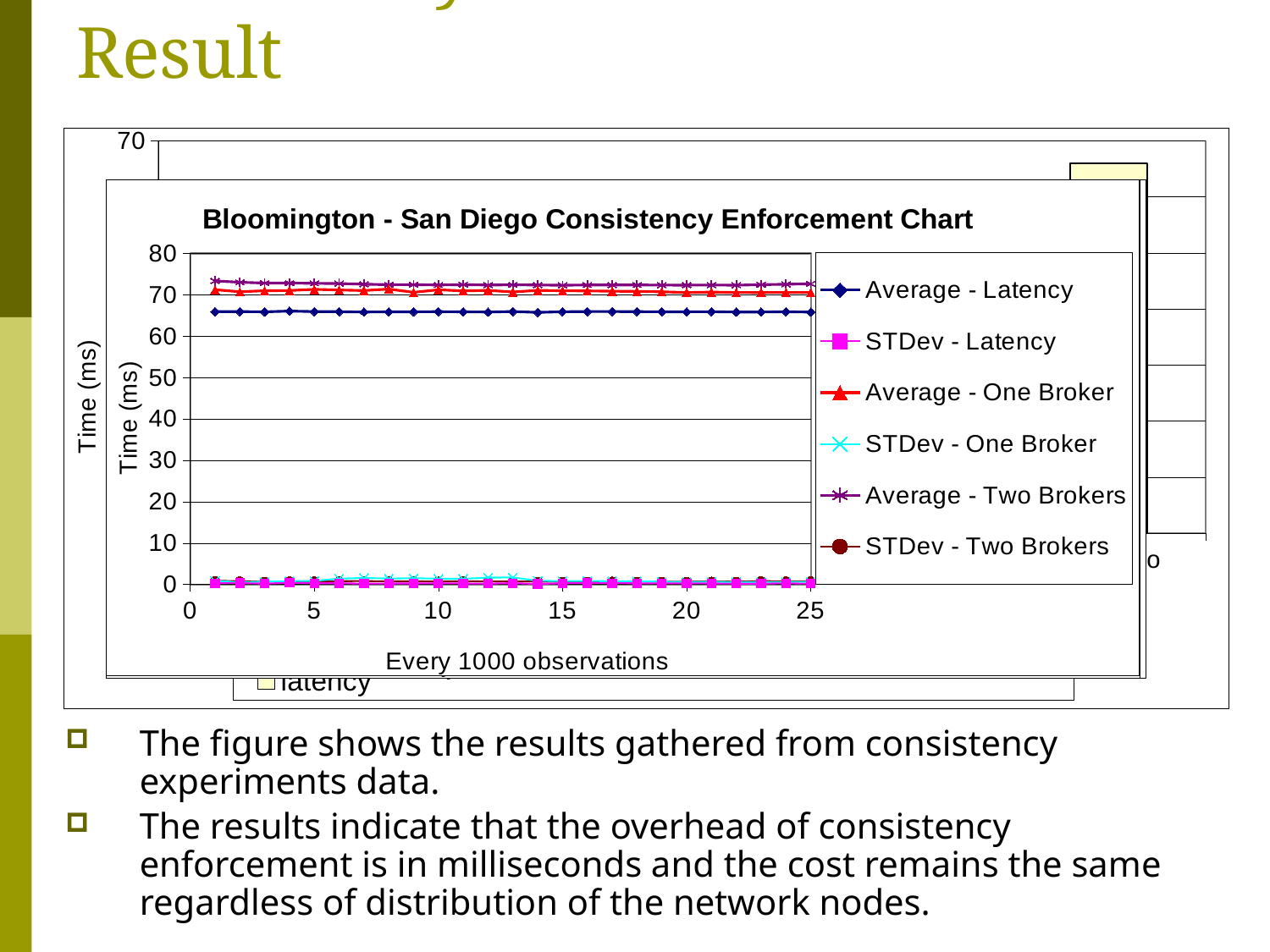
In the Bloomington - San Diego Consistency Enforcement Chart, which is larger: Average - One Broker or STDev - One Broker? Average - One Broker In the Bloomington - San Diego Consistency Enforcement Chart, are the values for Average - Latency greater or less than 70? less In the Bloomington - San Diego Consistency Enforcement Chart, are the values for Average - Two Brokers greater or less than 70? greater What kind of chart is the Bloomington - San Diego Consistency Enforcement Chart? line chart What is the title of the chart shown on the slide? Bloomington - San Diego Consistency Enforcement Chart In the Bloomington - San Diego Consistency Enforcement Chart, are the values for STDev - Latency greater or less than 10? less In the Bloomington - San Diego Consistency Enforcement Chart, do the Average - Latency values rise, fall, or stay roughly flat along the x axis? stay roughly flat In the Bloomington - San Diego Consistency Enforcement Chart, which is larger: Average - Two Brokers or Average - Latency? Average - Two Brokers How many series does the legend of the Bloomington - San Diego Consistency Enforcement Chart list? 6 What is the x-axis label of the Bloomington - San Diego Consistency Enforcement Chart? Every 1000 observations In the Bloomington - San Diego Consistency Enforcement Chart, which series has the highest values? Average - Two Brokers